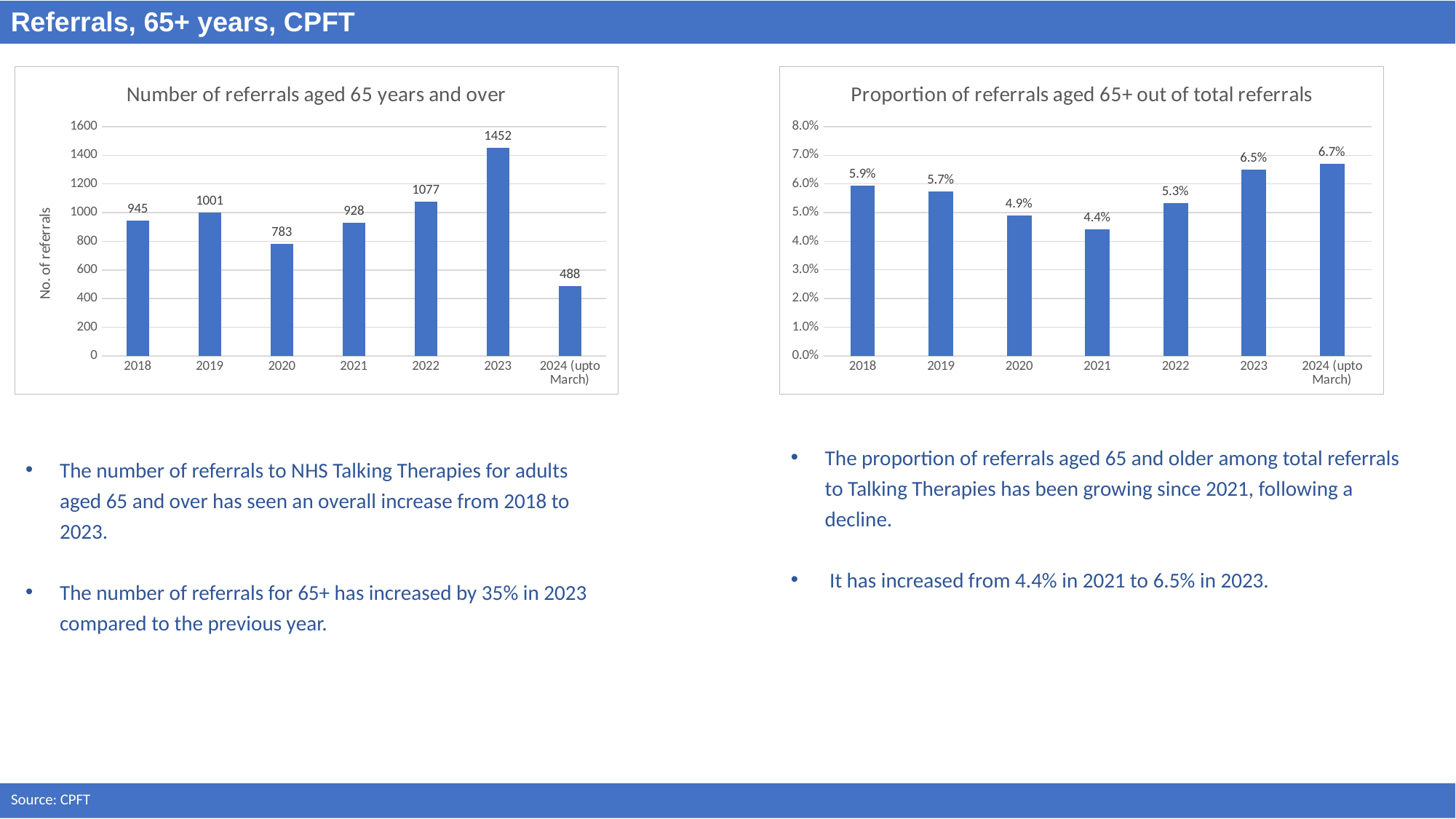
In the 'Proportion of referrals aged 65+ out of total referrals' chart, which category has the highest value? 2024 (upto March) In the 'Number of referrals aged 65 years and over' chart, which year has the highest number of referrals? 2023 In the 'Number of referrals aged 65 years and over' chart, what is the value for 2020? 783 In the 'Proportion of referrals aged 65+ out of total referrals' chart, do the values rise or fall from 2021 to 2023? Rise In the 'Number of referrals aged 65 years and over' chart, how many categories are shown on the x axis? 7 What kind of chart is 'Number of referrals aged 65 years and over'? Bar chart In the 'Proportion of referrals aged 65+ out of total referrals' chart, what is the value for 2021? 4.4% In the 'Number of referrals aged 65 years and over' chart, which category has the lowest value? 2024 (upto March) What is the y-axis label of the 'Number of referrals aged 65 years and over' chart? No. of referrals In the 'Proportion of referrals aged 65+ out of total referrals' chart, which year has the lowest proportion? 2021 In the 'Number of referrals aged 65 years and over' chart, what is the difference between the 2023 and 2022 values? 375 In the 'Proportion of referrals aged 65+ out of total referrals' chart, is the value for 2018 larger or the value for 2019? 2018